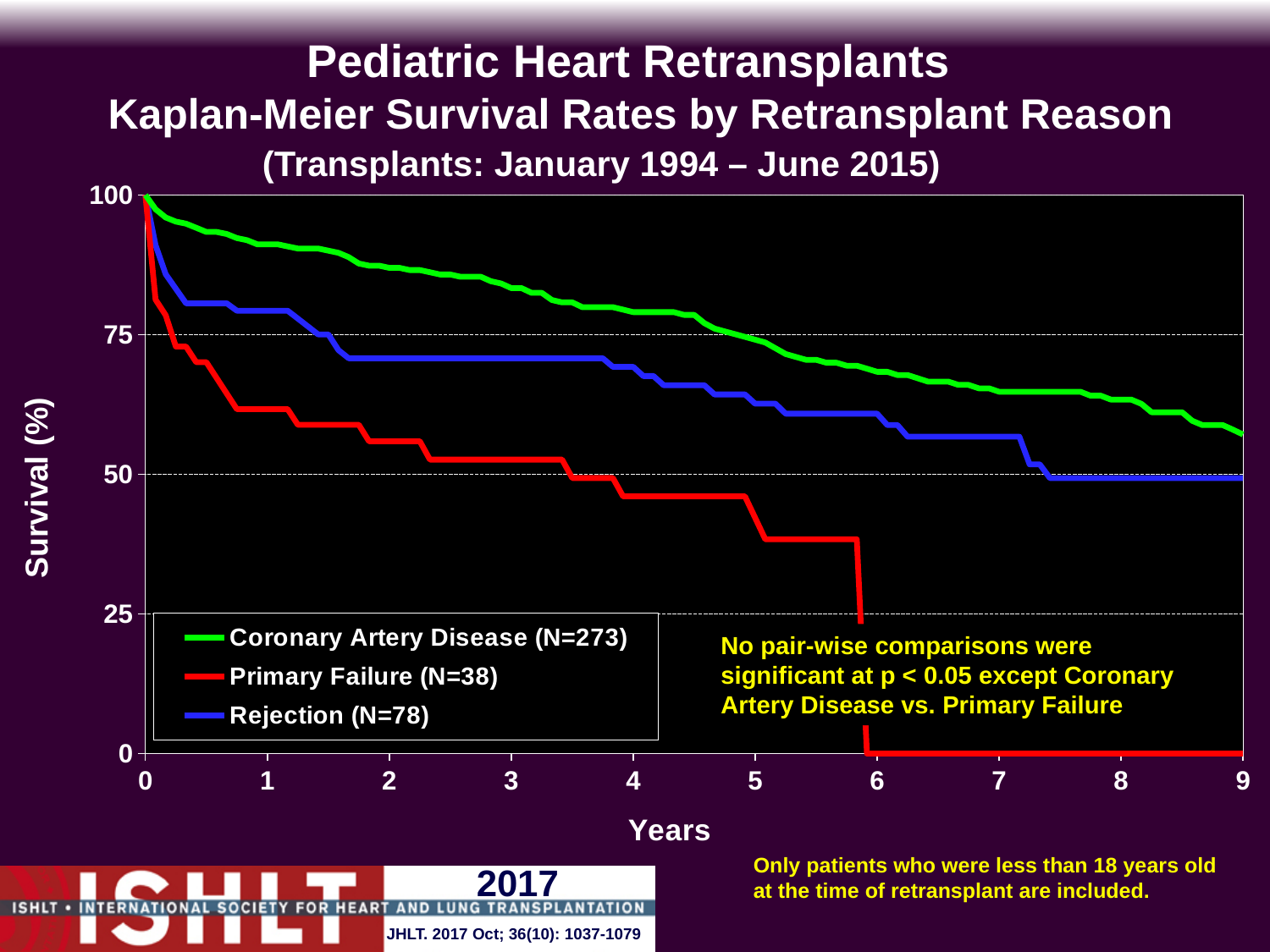
Is the survival value for Coronary Artery Disease at 9 years greater or less than 50? greater What is the sample size (N) shown in the legend for the Primary Failure series? N=38 What kind of chart is shown on the slide? Line chart What is the sample size (N) shown in the legend for the Coronary Artery Disease series? N=273 How many series does the legend list? 3 At 8 years, which series has higher survival, Coronary Artery Disease or Rejection? Coronary Artery Disease Which series has the lowest survival across the years shown? Primary Failure At 4 years, which series has higher survival, Coronary Artery Disease or Primary Failure? Coronary Artery Disease Which series has the highest survival across the years shown? Coronary Artery Disease Do the survival curves rise or fall as years increase? Fall Is the survival value for Primary Failure at 5 years greater or less than 50? less Is the survival value for Rejection at 2 years greater or less than 75? less